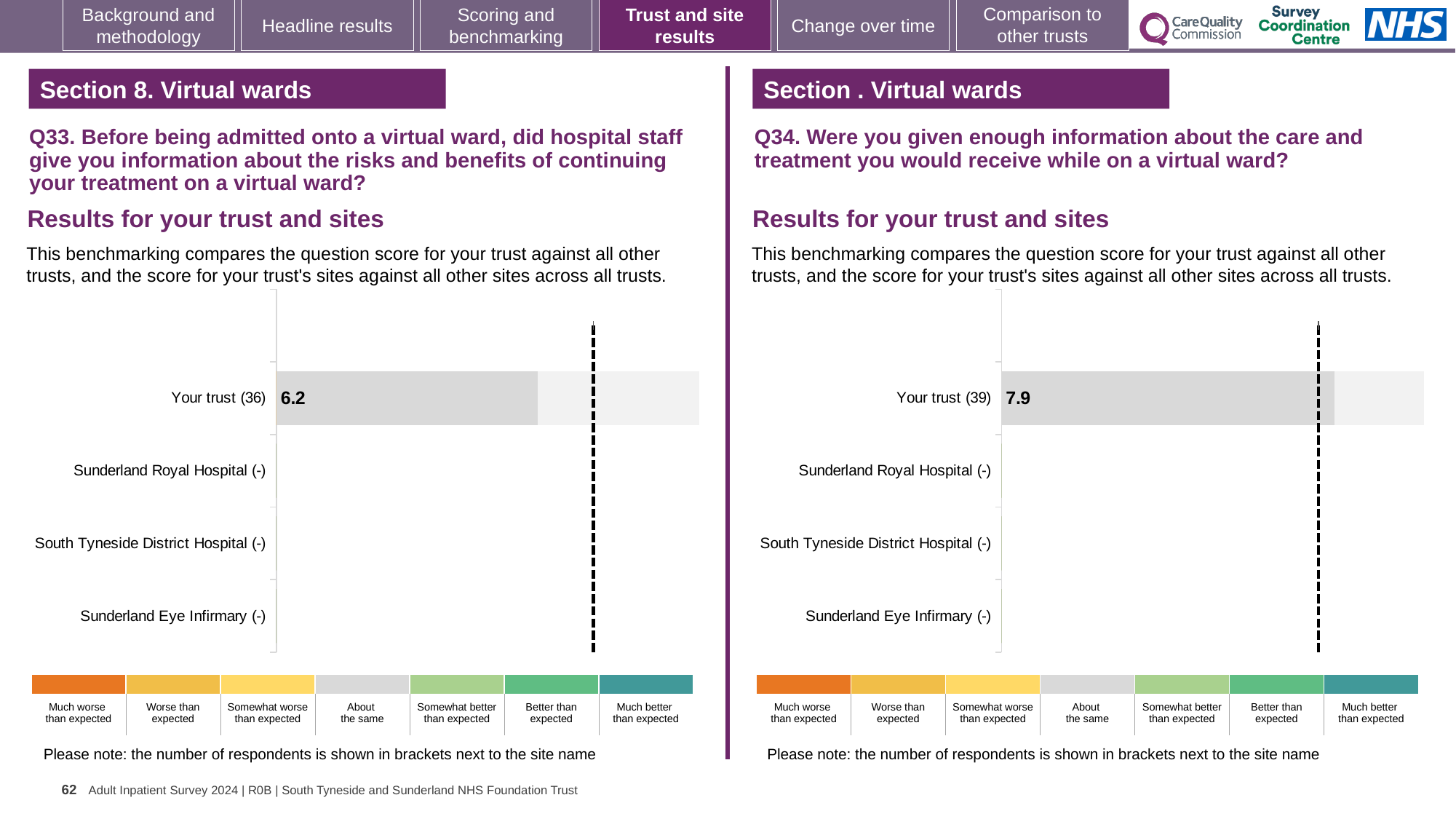
What is the difference between the Your trust score on the Q34 chart and the Your trust score on the Q33 chart? 1.7 On the Q34 chart (right), how many respondents are shown in brackets next to Your trust? 39 Which chart shows the higher score for Your trust, the Q33 chart on the left or the Q34 chart on the right? Q34 chart (right) On the Q33 chart (left), how many site rows show no score (marked with a dash)? 3 On the Q33 chart (left), how many respondents are shown in brackets next to Your trust? 36 On the Q33 chart (left), what is the score for Your trust? 6.2 On the Q34 chart (right), what is the score for Your trust? 7.9 What kind of chart is used on the Q34 chart (right)? Bar chart On the Q34 chart (right), which benchmark category does the grey colour of the Your trust bar correspond to in the key? About the same How many benchmark categories are shown in the colour key below the Q33 chart (left)? 7 On the Q33 chart (left), how many categories are listed on the vertical axis? 4